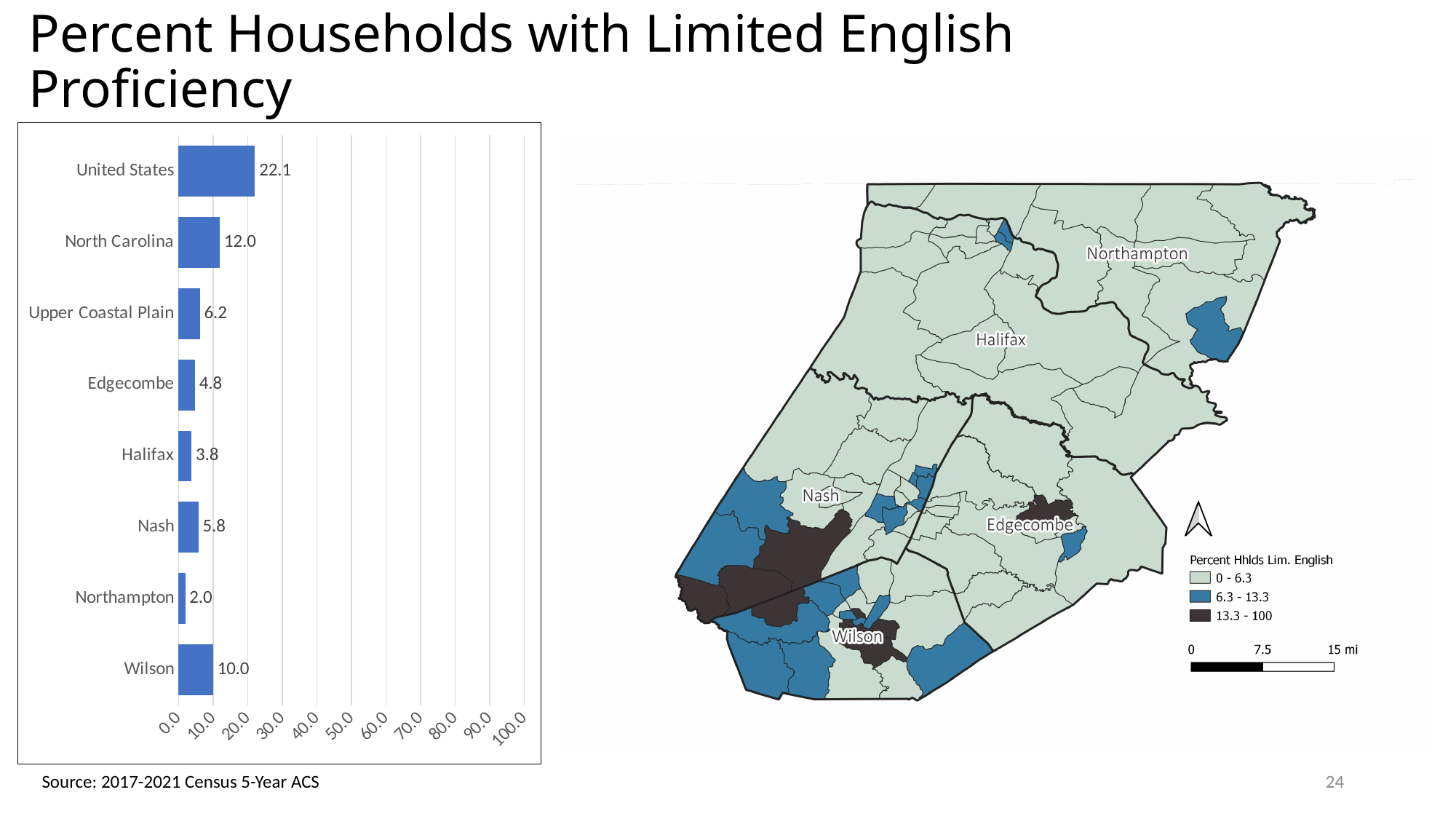
What is the value for the United States in the bar chart? 22.1 What is the difference between the values for North Carolina and Upper Coastal Plain in the bar chart? 5.8 What is the highest tick value on the x axis of the bar chart? 100.0 Which category has the highest value in the bar chart? United States What is the value for Northampton in the bar chart? 2.0 What is the difference between the values for Halifax and Northampton in the bar chart? 1.8 Is the value for Wilson in the bar chart greater or less than 20.0? less What kind of chart is shown on the left of the slide? bar chart Which has a larger value in the bar chart, Edgecombe or Nash? Nash Which category has the lowest value in the bar chart? Northampton What is the value for Wilson in the bar chart? 10.0 How many categories are shown in the bar chart? 8